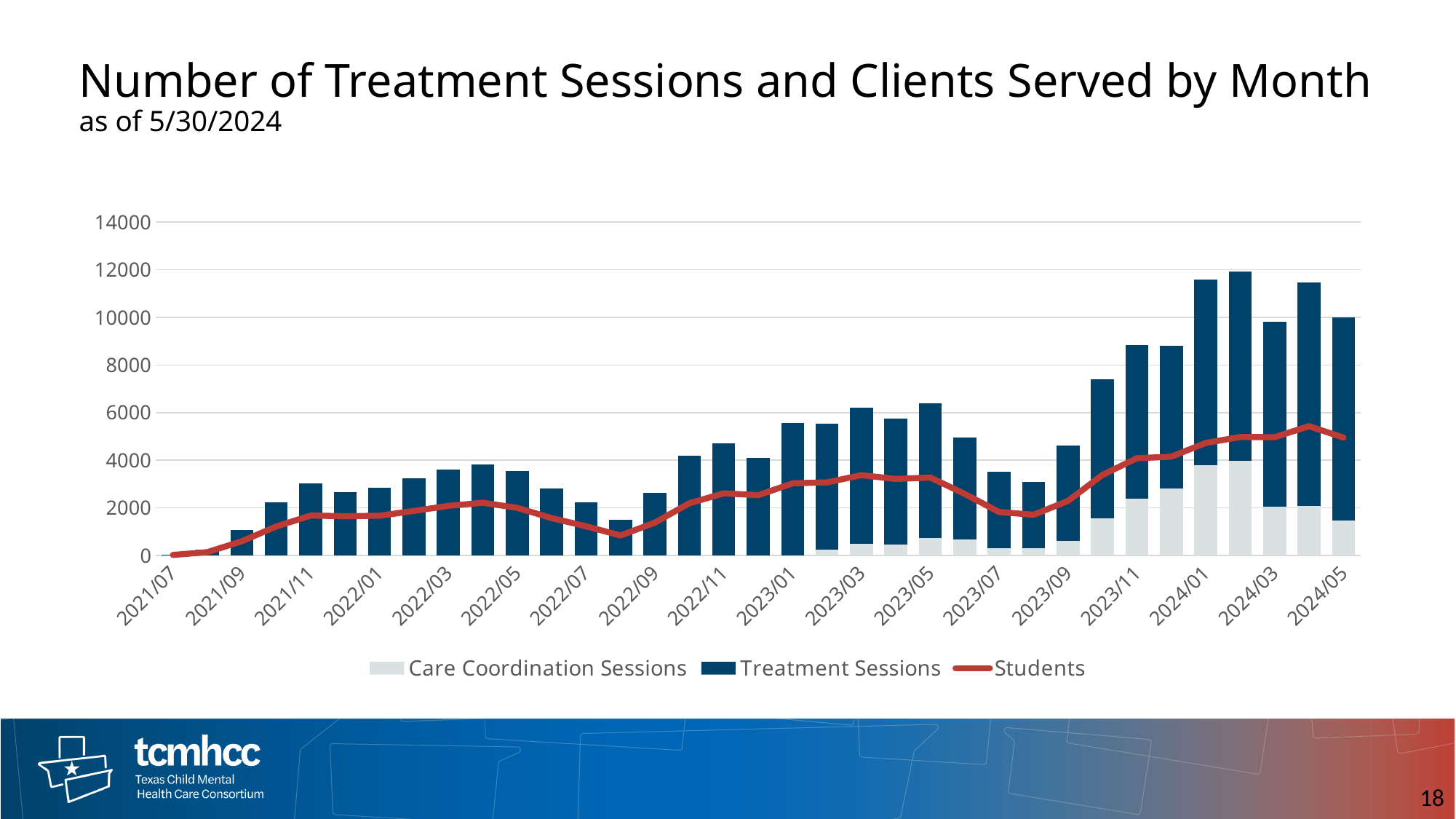
Do the stacked bar totals rise or fall from 2023/09 to 2024/01? rise Which series is shown as a red line? Students Does the Students line rise or fall from 2021/07 to 2022/03? rise Is the Students value for 2024/05 greater or less than 4000? greater What date is the chart reported as of, according to the subtitle? 5/30/2024 Is the total stacked bar value for 2023/01 greater or less than 4000? greater Is the total stacked bar value for 2023/07 greater or less than 4000? less What kind of chart is this? Bar chart with a line series How many series does the legend list? 3